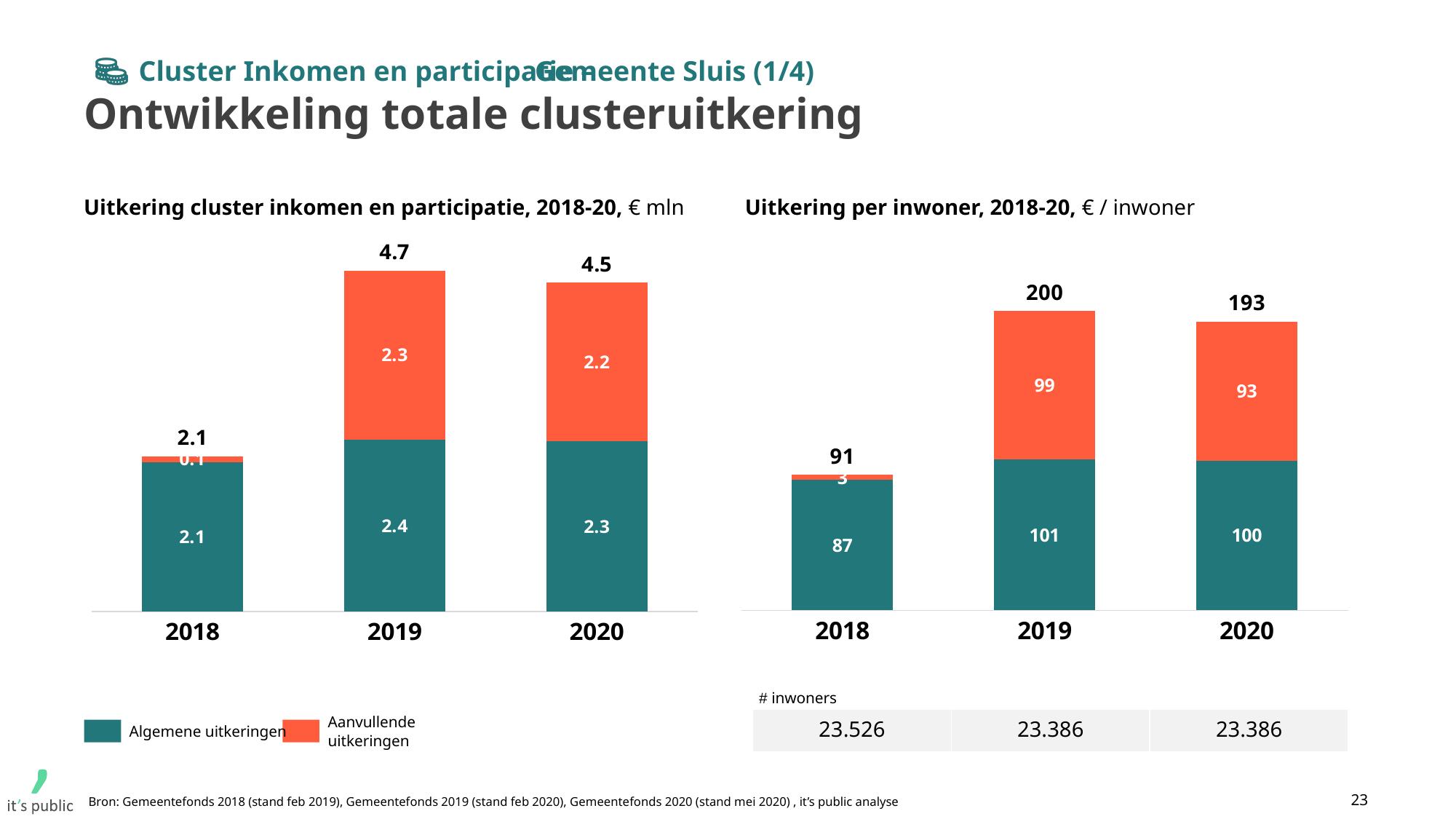
How many series does the legend list for the charts on this slide? 2 What type of chart is the left chart (Uitkering cluster inkomen en participatie)? Stacked bar chart In the right chart (Uitkering per inwoner), is the Algemene uitkeringen value for 2019 larger or smaller than for 2020? larger In the right chart (Uitkering per inwoner), what is the value of Aanvullende uitkeringen for 2019? 99 In the left chart (Uitkering cluster inkomen en participatie), what is the total value for 2019? 4.7 In the left chart (Uitkering cluster inkomen en participatie), what is the value of Aanvullende uitkeringen for 2018? 0.1 In the right chart (Uitkering per inwoner), which year has the highest total? 2019 In the left chart (Uitkering cluster inkomen en participatie), what is the value of Algemene uitkeringen for 2020? 2.3 In the right chart (Uitkering per inwoner), what is the total value for 2020? 193 In the right chart (Uitkering per inwoner), what is the difference between the totals for 2019 and 2018? 109 In the left chart (Uitkering cluster inkomen en participatie), what is the difference between the totals for 2019 and 2020? 0.2 In the left chart (Uitkering cluster inkomen en participatie), which year has the lowest total? 2018